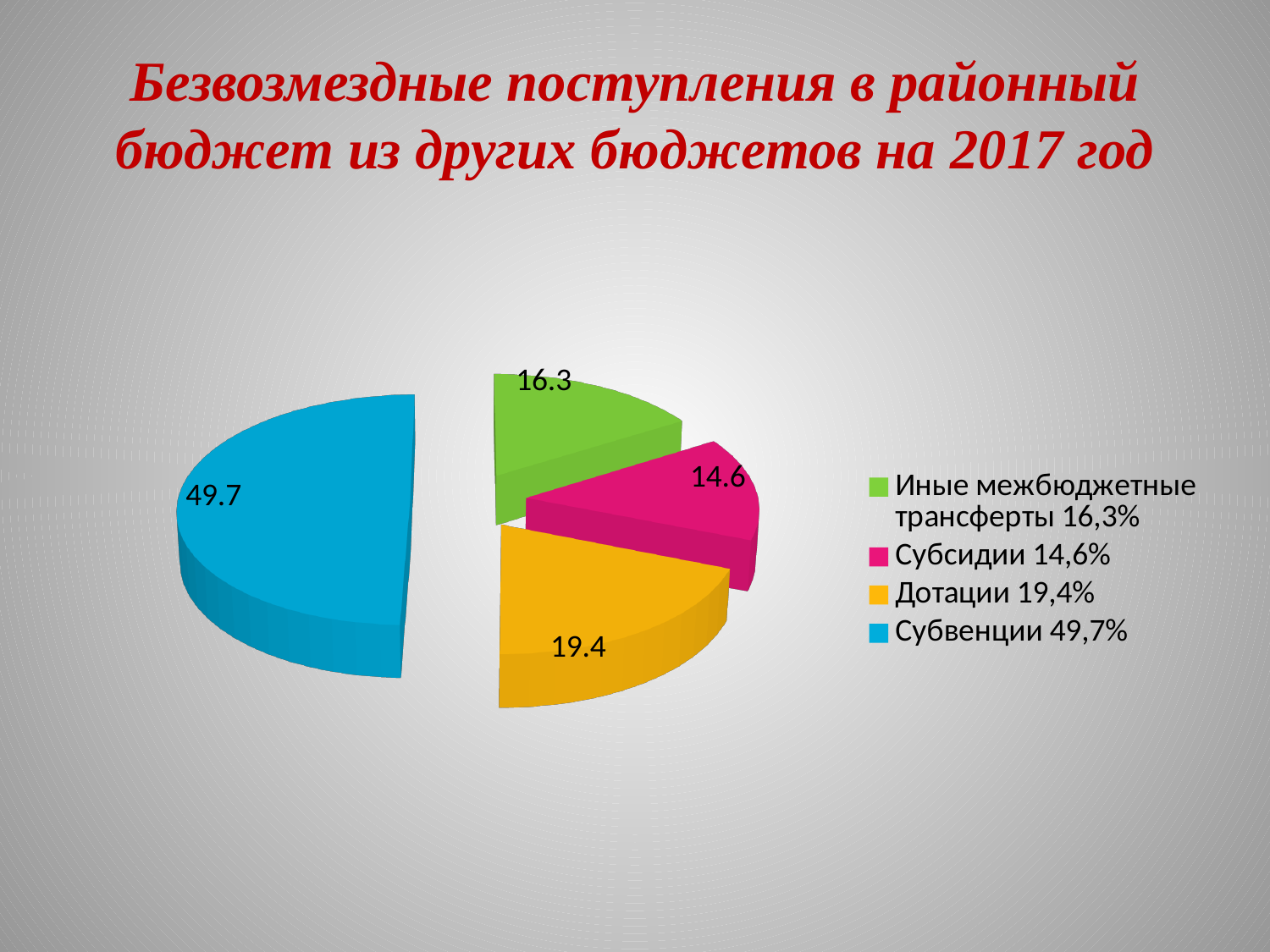
How many slices does the pie chart have? 4 Which is larger, the Дотации slice or the Иные межбюджетные трансферты slice? Дотации Which category has the smallest slice? Субсидии What is the value labelled on the Иные межбюджетные трансферты slice? 16.3 What is the value labelled on the Дотации slice? 19.4 What colour is the Субвенции slice? blue Which category has the largest slice? Субвенции What is the value labelled on the Субвенции slice? 49.7 What is the value labelled on the Субсидии slice? 14.6 How many entries does the legend list? 4 What kind of chart is shown on the slide? pie chart What is the difference between the Субвенции value and the Дотации value? 30.3